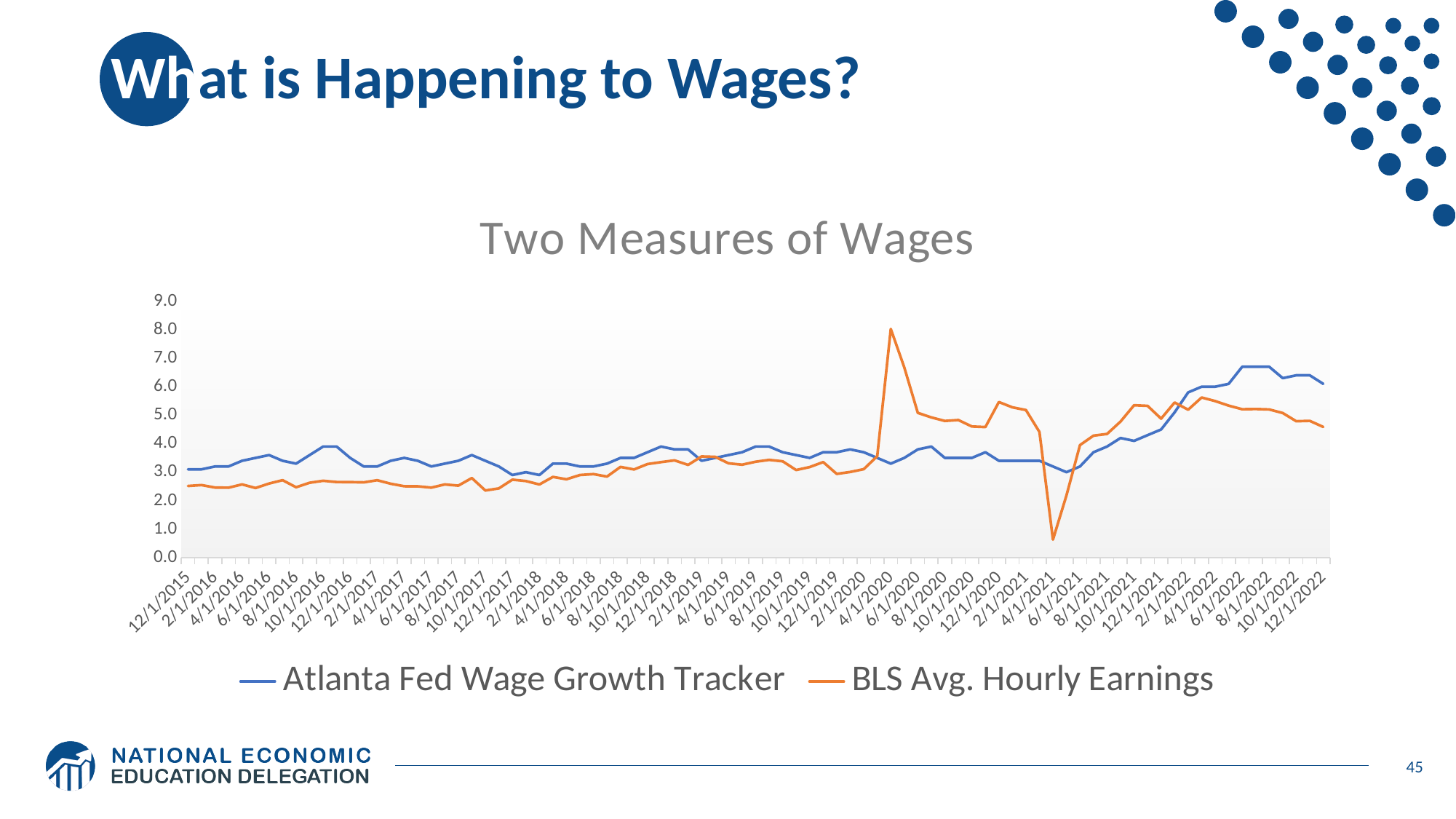
How many series does the legend list? 2 Which series reaches the highest value anywhere on the chart? BLS Avg. Hourly Earnings What kind of chart is shown on the slide? Line chart Is the value for BLS Avg. Hourly Earnings at 4/1/2020 greater or less than 7.0? greater What is the title of the chart? Two Measures of Wages Which series reaches the lowest value anywhere on the chart? BLS Avg. Hourly Earnings Is the value for BLS Avg. Hourly Earnings at 4/1/2021 greater or less than 1.0? less At 4/1/2020, which series has the higher value, Atlanta Fed Wage Growth Tracker or BLS Avg. Hourly Earnings? BLS Avg. Hourly Earnings Does the Atlanta Fed Wage Growth Tracker series rise or fall between 6/1/2021 and 6/1/2022? rise Which series is drawn in orange? BLS Avg. Hourly Earnings Is the value for Atlanta Fed Wage Growth Tracker at 6/1/2022 greater or less than 6.0? greater At 6/1/2022, which series has the higher value, Atlanta Fed Wage Growth Tracker or BLS Avg. Hourly Earnings? Atlanta Fed Wage Growth Tracker